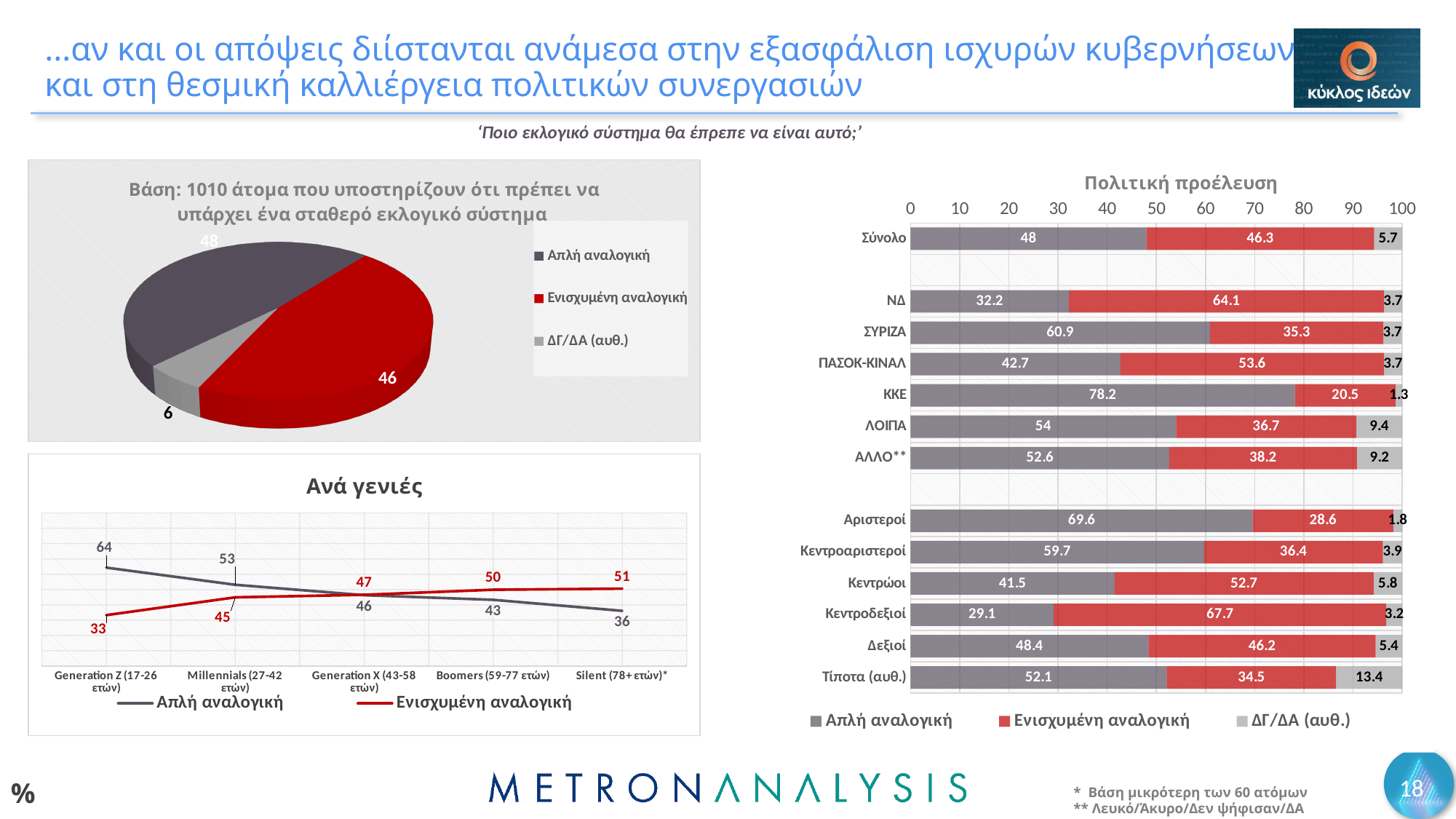
In the 'Πολιτική προέλευση' chart, which category has the highest Ενισχυμένη αναλογική value? Κεντροδεξιοί In the 'Ανά γενιές' chart, what is the value of Ενισχυμένη αναλογική for Silent (78+ ετών)*? 51 In the 'Ανά γενιές' chart, what is the value of Απλή αναλογική for Generation Z (17-26 ετών)? 64 In the pie chart at the top left, what is the difference between the Απλή αναλογική and Ενισχυμένη αναλογική values? 2 In the pie chart at the top left, what is the value for Απλή αναλογική? 48 In the 'Πολιτική προέλευση' chart, how many series does the legend list? 3 In the 'Πολιτική προέλευση' chart, what is the Απλή αναλογική value for ΚΚΕ? 78.2 In the pie chart at the top left, which category has the smallest slice? ΔΓ/ΔΑ (αυθ.) In the 'Ανά γενιές' chart, how many generation categories are shown on the x axis? 5 In the 'Ανά γενιές' chart, does the Απλή αναλογική line rise or fall from Generation Z to Silent? fall In the 'Πολιτική προέλευση' chart, which is larger for ΝΔ: Απλή αναλογική or Ενισχυμένη αναλογική? Ενισχυμένη αναλογική In the 'Πολιτική προέλευση' chart, what is the ΔΓ/ΔΑ (αυθ.) value for Τίποτα (αυθ.)? 13.4